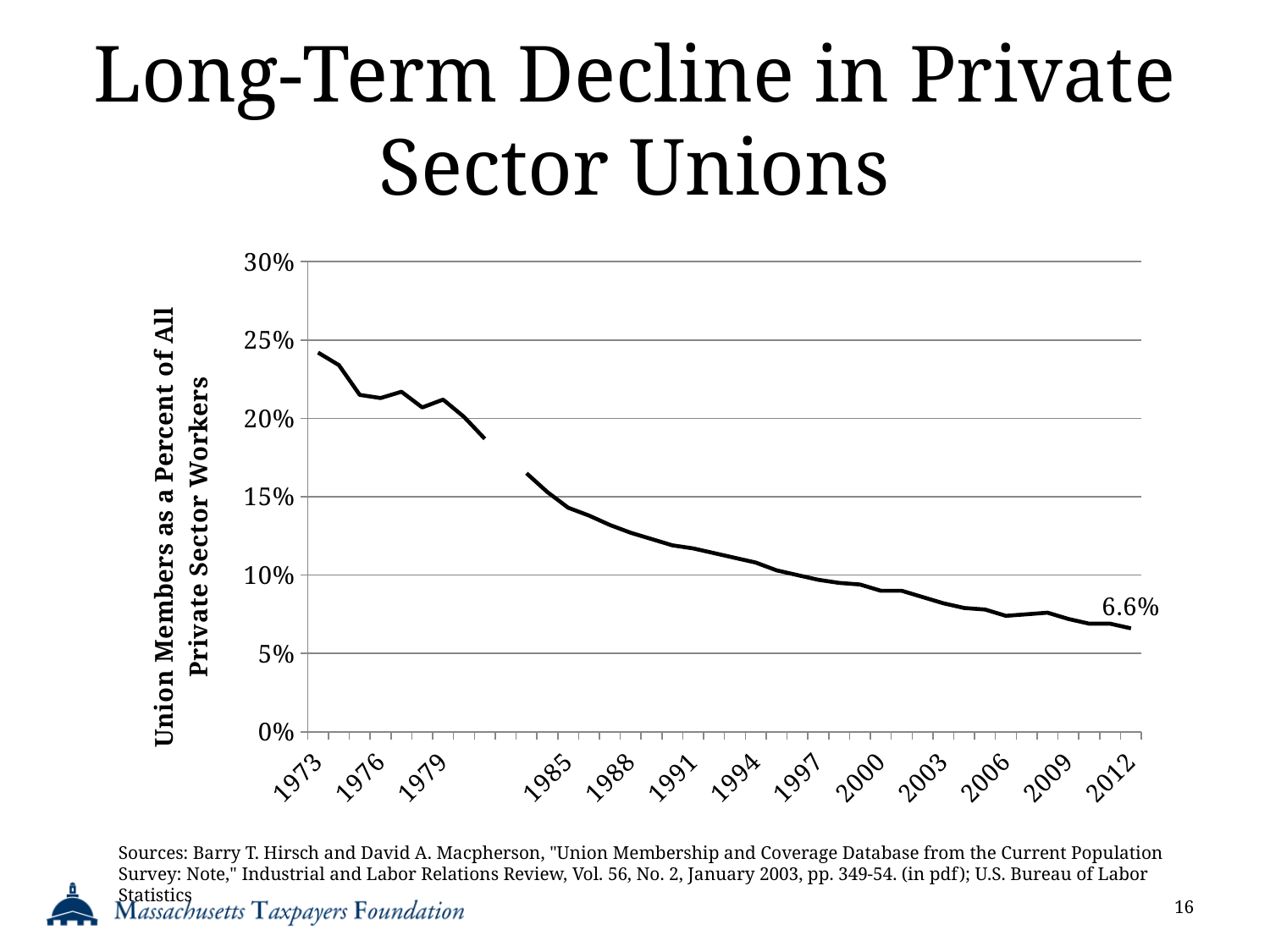
Which is larger, the value for 1976 or the value for 2000? 1976 Is the value for 2006 greater or less than 10%? less Which year has the highest value on the chart? 1973 Is the value for 1985 greater or less than 20%? less Is the value for 1973 greater or less than 20%? greater Do the values rise or fall from 1973 to 2012? fall What is the value shown for 2012? 6.6% What kind of chart is shown on the slide? line chart Which year has the lowest value on the chart? 2012 What is the title of the chart's vertical axis? Union Members as a Percent of All Private Sector Workers What is the title of the slide? Long-Term Decline in Private Sector Unions